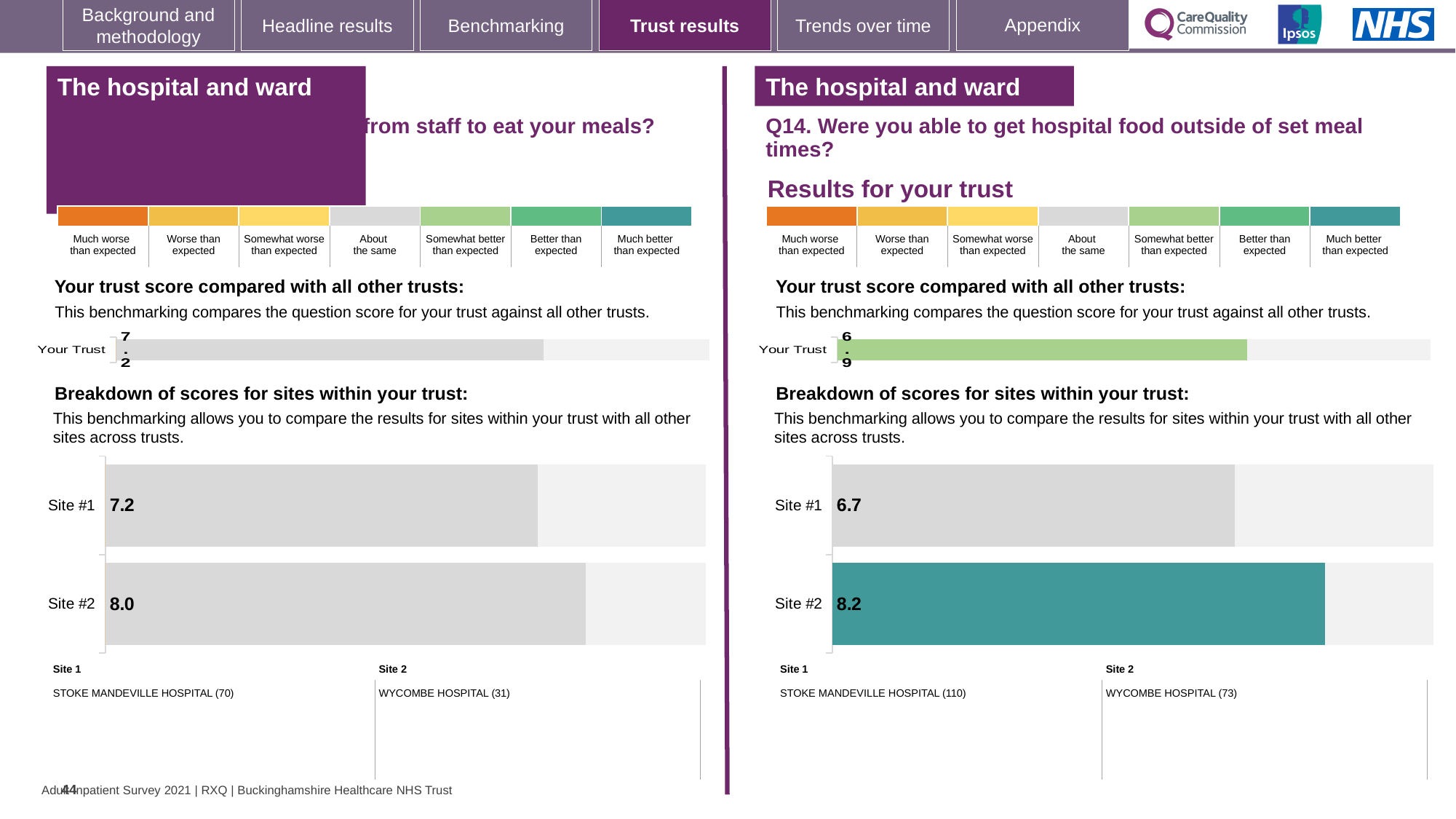
What type of chart is used for the 'Breakdown of scores for sites within your trust' on the right-hand side of the slide? Bar chart In the left-hand site breakdown chart, which site has the lower score? Site #1 In the right-hand 'Breakdown of scores for sites within your trust' chart (Q14), what is the score for Site #2? 8.2 In the right-hand 'Breakdown of scores for sites within your trust' chart (Q14), what is the score for Site #1? 6.7 On the left-hand side of the slide, what is the trust score shown in the 'Your trust score compared with all other trusts' bar chart? 7.2 In the left-hand 'Breakdown of scores for sites within your trust' chart, what is the score for Site #1? 7.2 In the right-hand site breakdown chart (Q14), what is the difference between the Site #2 score and the Site #1 score? 1.5 In the left-hand site breakdown chart, what is the difference between the Site #2 score and the Site #1 score? 0.8 In the right-hand site breakdown chart (Q14), which site has the higher score? Site #2 How many sites are shown in the right-hand 'Breakdown of scores for sites within your trust' chart (Q14)? 2 In the left-hand 'Breakdown of scores for sites within your trust' chart, what is the score for Site #2? 8.0 On the right-hand side of the slide (Q14), what is the trust score shown in the 'Your trust score compared with all other trusts' bar chart? 6.9